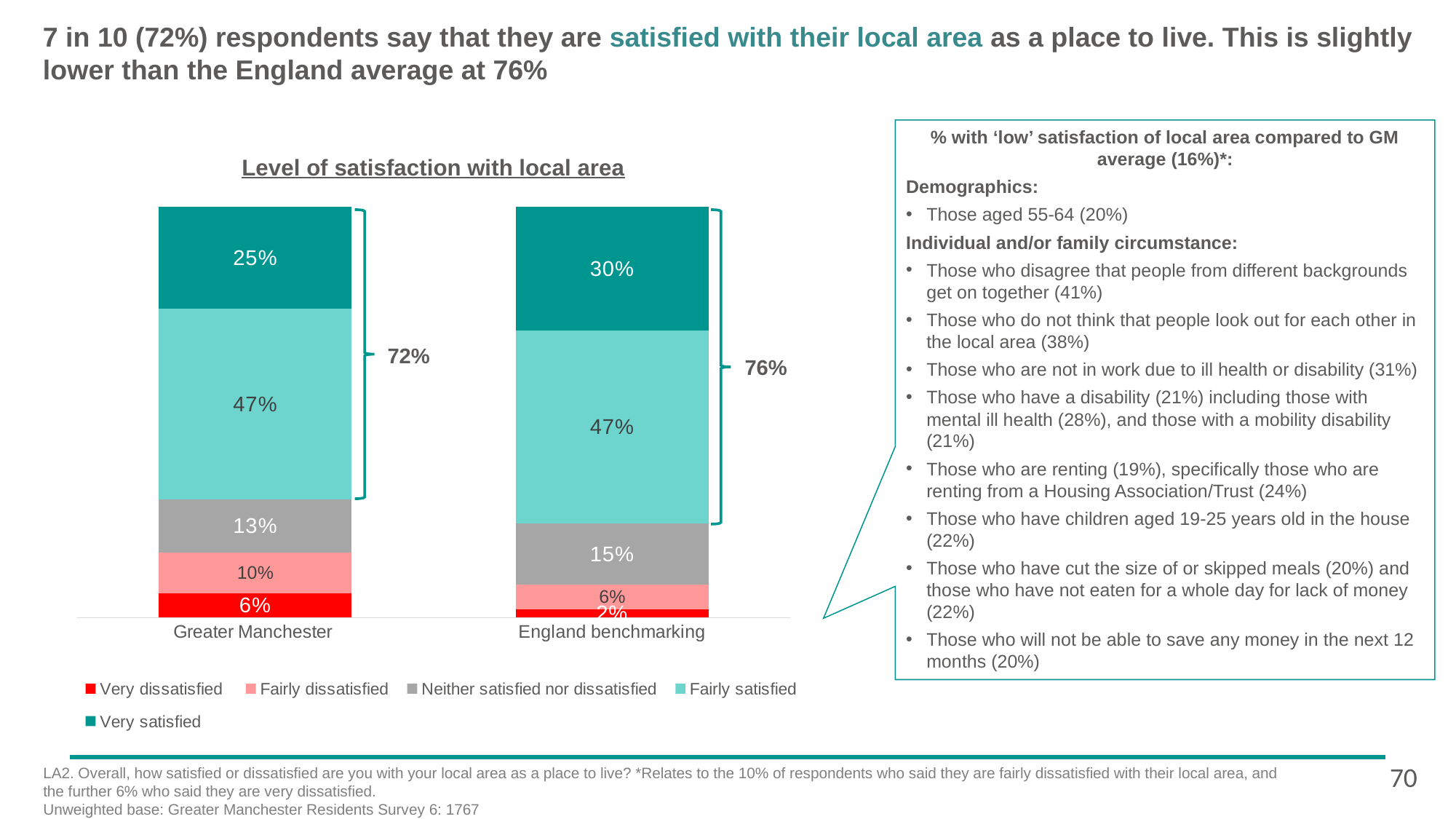
What is the difference between the "Very satisfied" values for England benchmarking and Greater Manchester? 5% How many categories are shown on the x axis of the chart? 2 What is the combined "Fairly satisfied" and "Very satisfied" total shown for Greater Manchester? 72% What is the "Very dissatisfied" value for Greater Manchester? 6% What is the "Very satisfied" value for Greater Manchester? 25% How many series does the chart's legend list? 5 What is the "Neither satisfied nor dissatisfied" value for England benchmarking? 15% Which category has the higher "Very satisfied" value, Greater Manchester or England benchmarking? England benchmarking What is the "Fairly dissatisfied" value for England benchmarking? 6% What type of chart is shown under the title "Level of satisfaction with local area"? Stacked bar chart Which series in the chart is shown in red? Very dissatisfied What is the "Very satisfied" value for England benchmarking? 30%